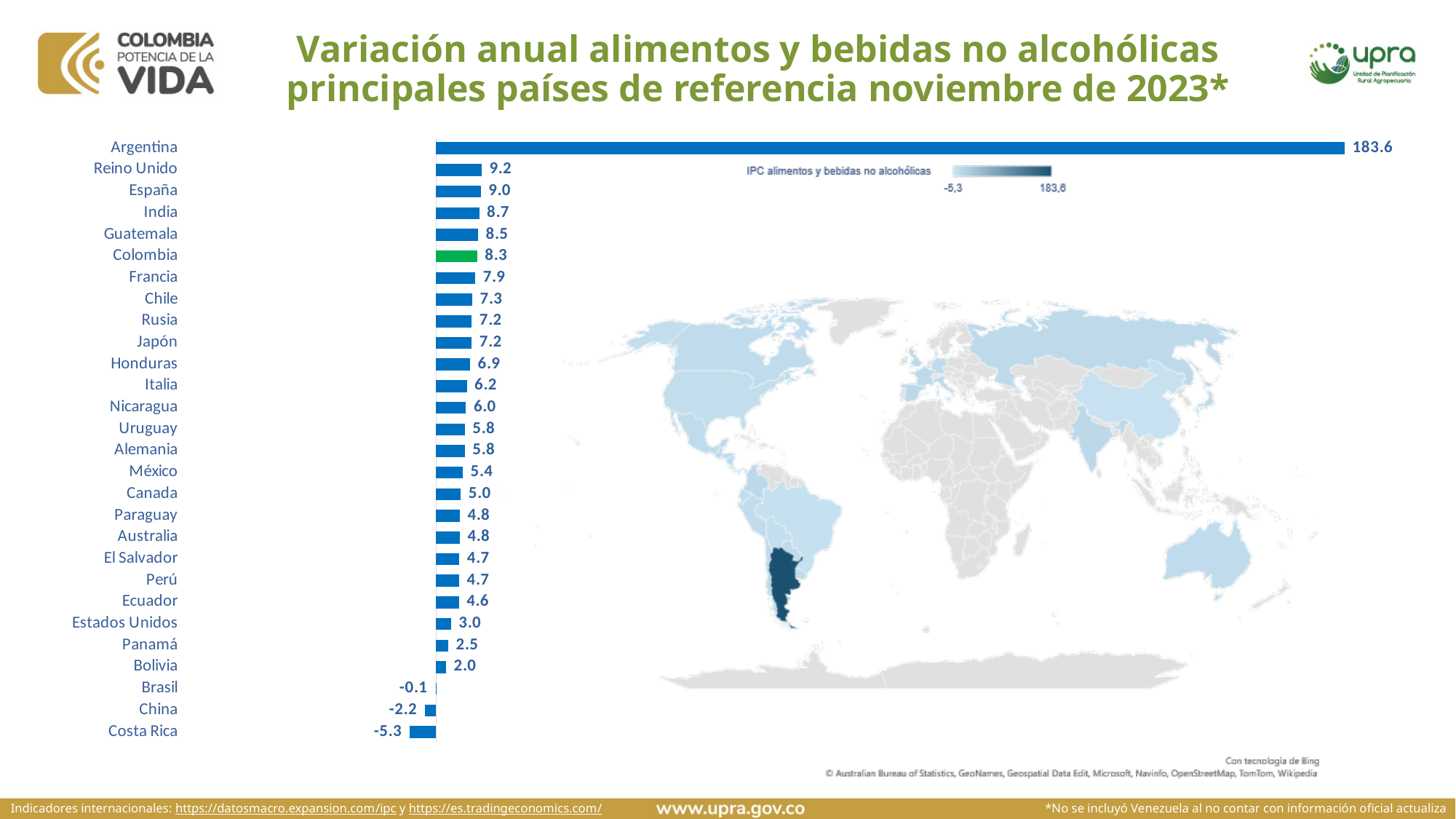
What is the value shown for Estados Unidos in the bar chart? 3.0 What is the value shown for Argentina in the bar chart? 183.6 What is the difference between the values for Argentina and Reino Unido? 174.4 What is the difference between the values for Reino Unido and Colombia? 0.9 Which country has the lowest value in the bar chart? Costa Rica What is the value shown for Colombia in the bar chart? 8.3 Which has a larger value, Chile or Honduras? Chile What is the value shown for Costa Rica in the bar chart? -5.3 Which country's bar is coloured green instead of blue? Colombia What type of chart is used to show the values by country? Bar chart How many countries are shown in the bar chart? 28 Which country has the highest value in the bar chart? Argentina